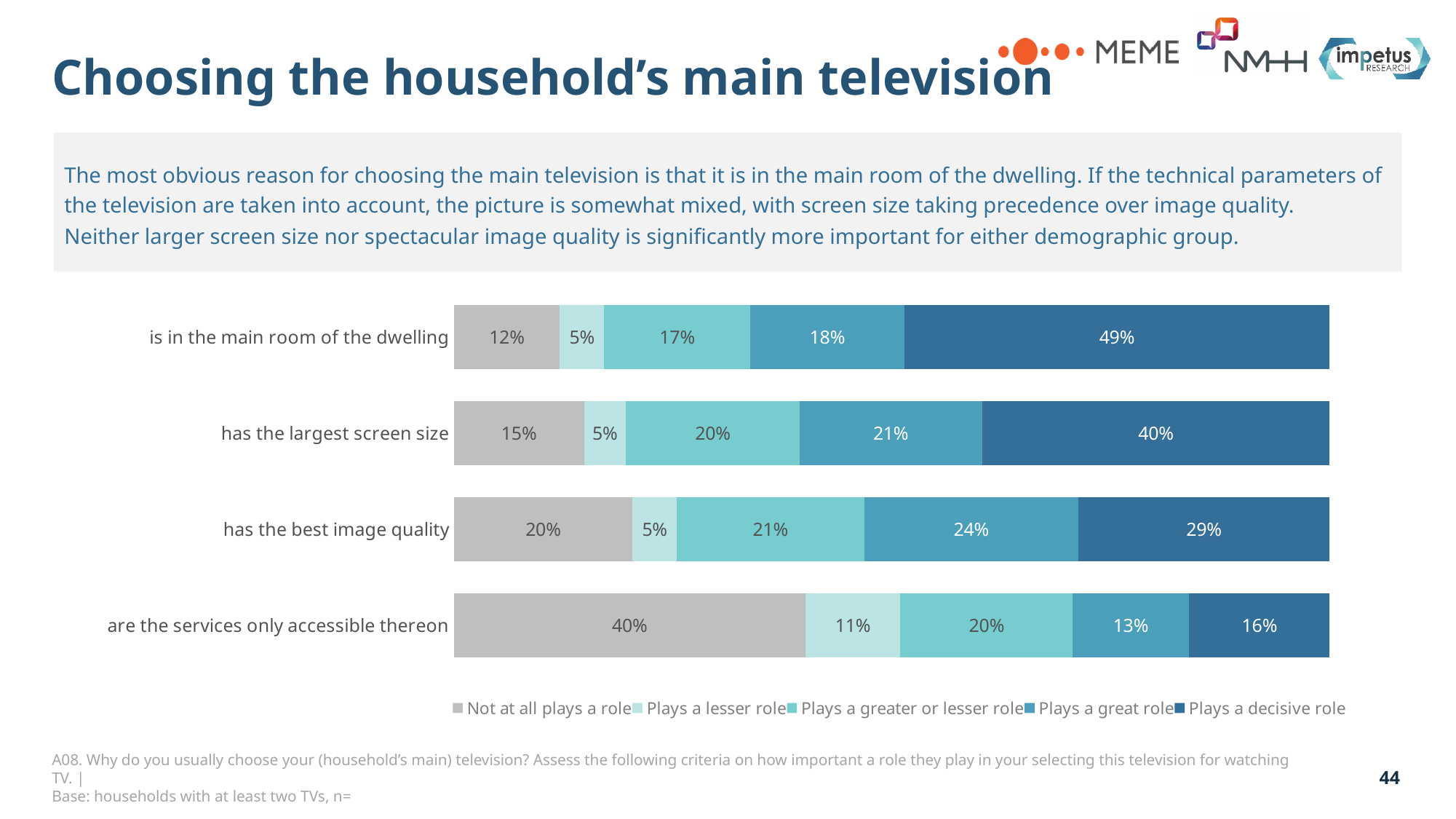
What is the "Plays a lesser role" value for "are the services only accessible thereon"? 11% What type of chart is shown on the slide? Stacked bar chart Which has the larger "Plays a great role" value: "has the largest screen size" or "has the best image quality"? has the best image quality Which criterion has the lowest "Plays a decisive role" value? are the services only accessible thereon How many criteria (bars) are shown in the chart? 4 What percentage of respondents said that the television being in the main room of the dwelling plays a decisive role? 49% What colour represents "Not at all plays a role" in the chart? Grey Which criterion has the highest "Plays a decisive role" value? is in the main room of the dwelling What is the "Plays a great role" value for "has the best image quality"? 24% How many percentage points higher is the "Plays a decisive role" value for "is in the main room of the dwelling" than for "has the largest screen size"? 9 percentage points How many series does the legend list? 5 What is the value for "Not at all plays a role" for "are the services only accessible thereon"? 40%